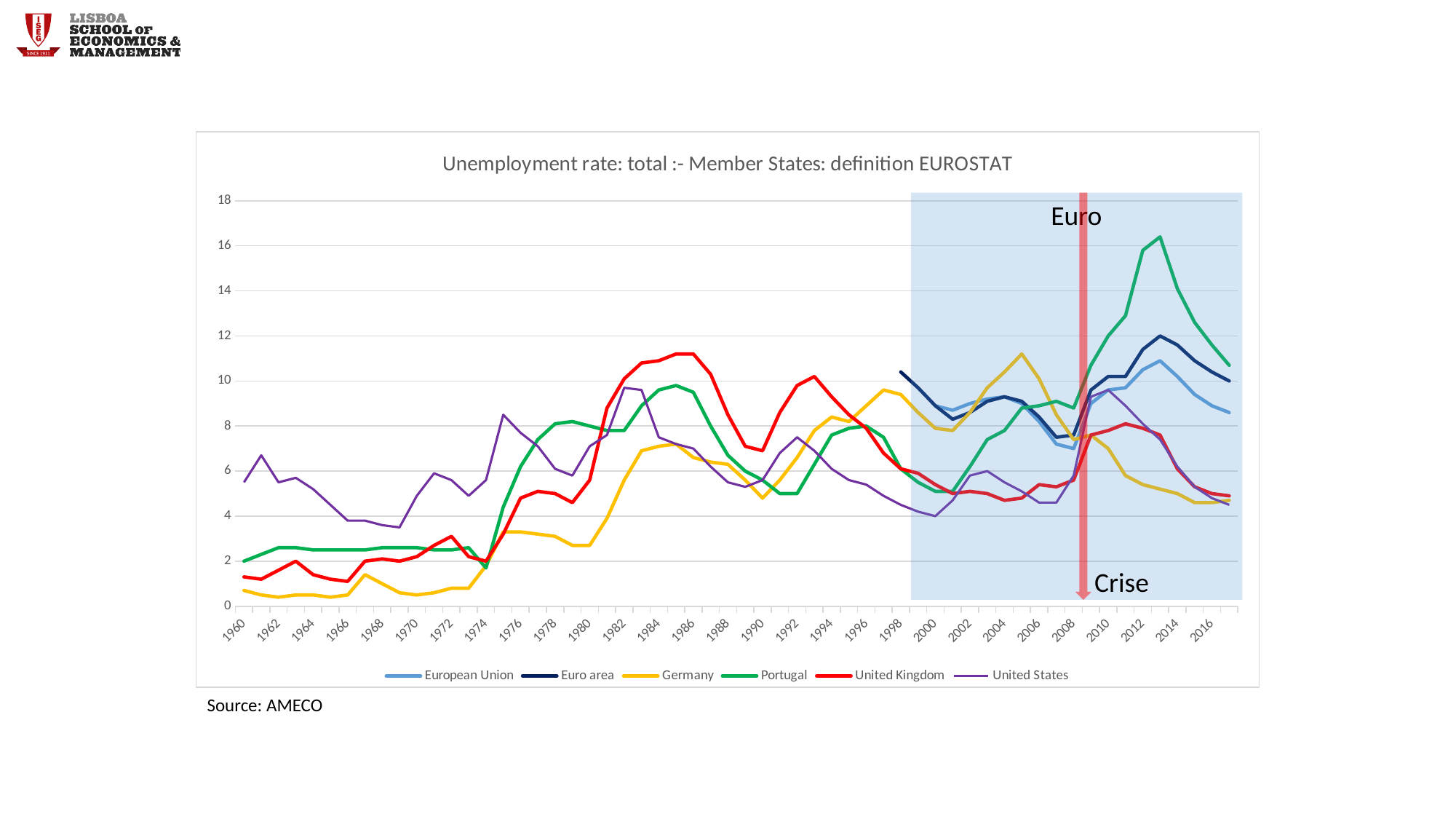
Which series has the lowest value in 1960? Germany Which series reaches the highest value anywhere on the chart? Portugal Does the Portugal line rise or fall between 2008 and 2013? rise Does the Germany line rise or fall between 2005 and 2016? fall Is the value for Portugal in 2013 greater or less than 14? greater Is the value for Germany in 1960 greater or less than 2? less In 2013, which is larger, the value for Portugal or the value for Germany? Portugal Is the value for the United States in 2000 greater or less than 6? less What is the title of the chart? Unemployment rate: total :- Member States: definition EUROSTAT How many series does the legend list? 6 What kind of chart is shown on the slide? line chart